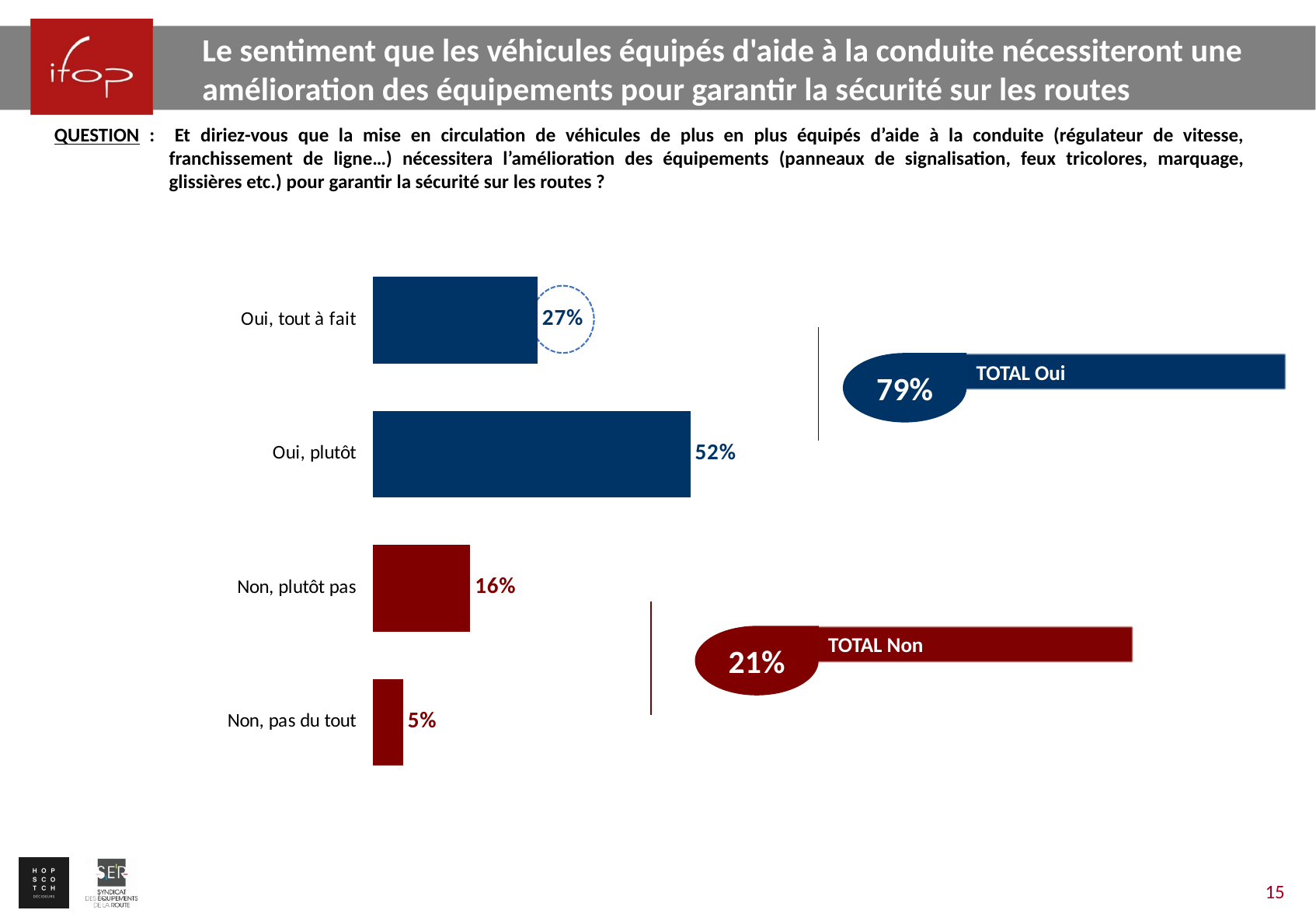
Which category has the lowest value? Non, pas du tout What is the value for "Oui, plutôt"? 52% Which is larger, "Non, plutôt pas" or "Non, pas du tout"? Non, plutôt pas What is the value for "Oui, tout à fait"? 27% What kind of chart is shown on the slide? Bar chart What is the value shown for "TOTAL Oui"? 79% What is the value shown for "TOTAL Non"? 21% What is the difference between "Oui, plutôt" and "Oui, tout à fait"? 25% What is the value for "Non, pas du tout"? 5% Which category has the highest value? Oui, plutôt What is the value for "Non, plutôt pas"? 16% How many categories are shown in the bar chart? 4